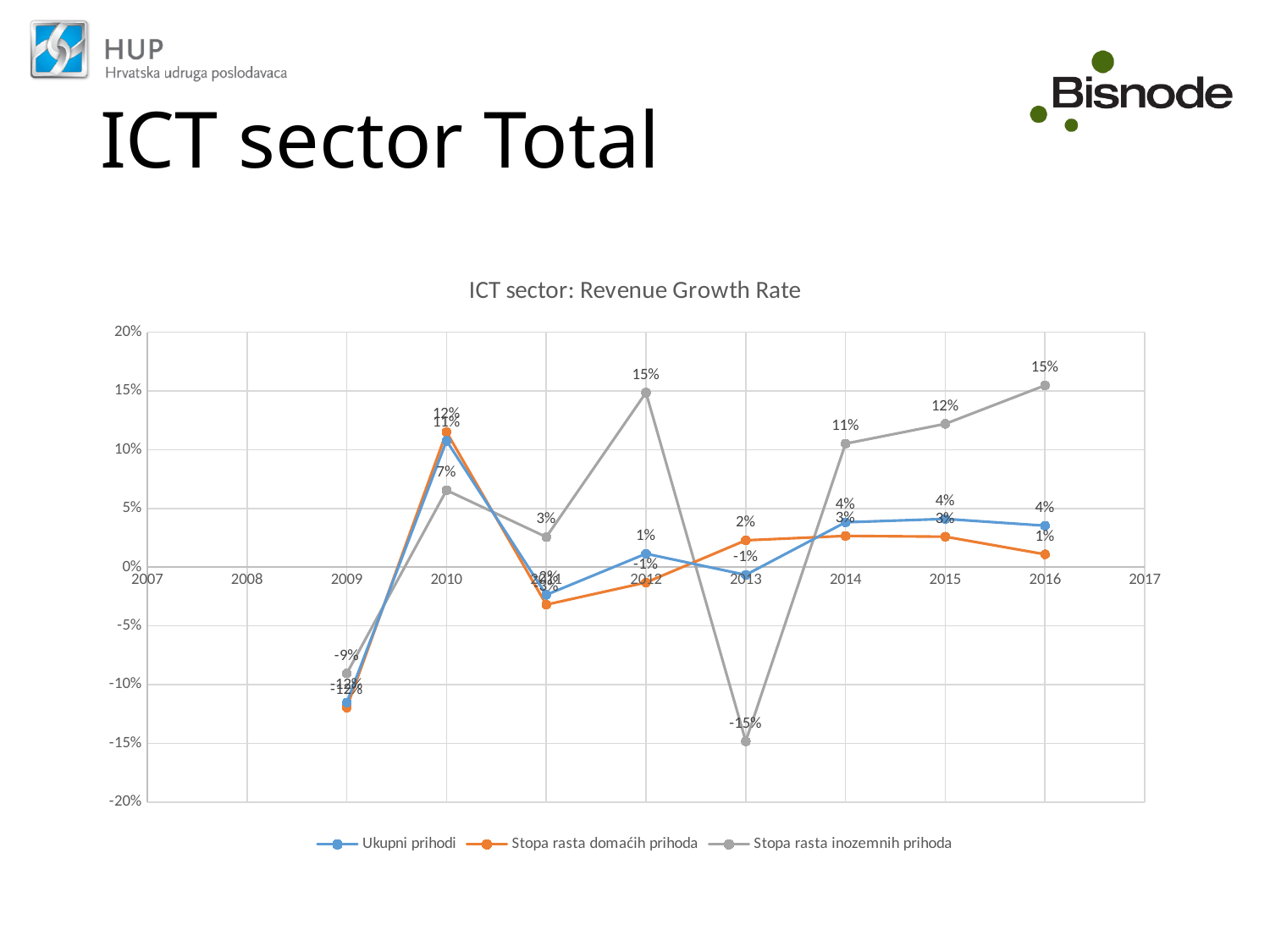
Does Stopa rasta inozemnih prihoda rise or fall from 2014 to 2016? Rise What is the value of Stopa rasta domaćih prihoda in 2016? 1% How many series does the legend list? 3 What is the value of Stopa rasta inozemnih prihoda in 2013? -15% In which year is Stopa rasta inozemnih prihoda at its lowest? 2013 What kind of chart is shown on the slide? Line chart What is the difference in percentage points between Stopa rasta inozemnih prihoda in 2012 and in 2013? 30 percentage points What is the value of Stopa rasta inozemnih prihoda in 2012? 15% What is the value of Ukupni prihodi in 2016? 4% In 2014, which is larger: Stopa rasta inozemnih prihoda or Ukupni prihodi? Stopa rasta inozemnih prihoda Is the value for Stopa rasta inozemnih prihoda in 2013 greater or less than -10%? less In which year is Stopa rasta domaćih prihoda at its highest? 2010